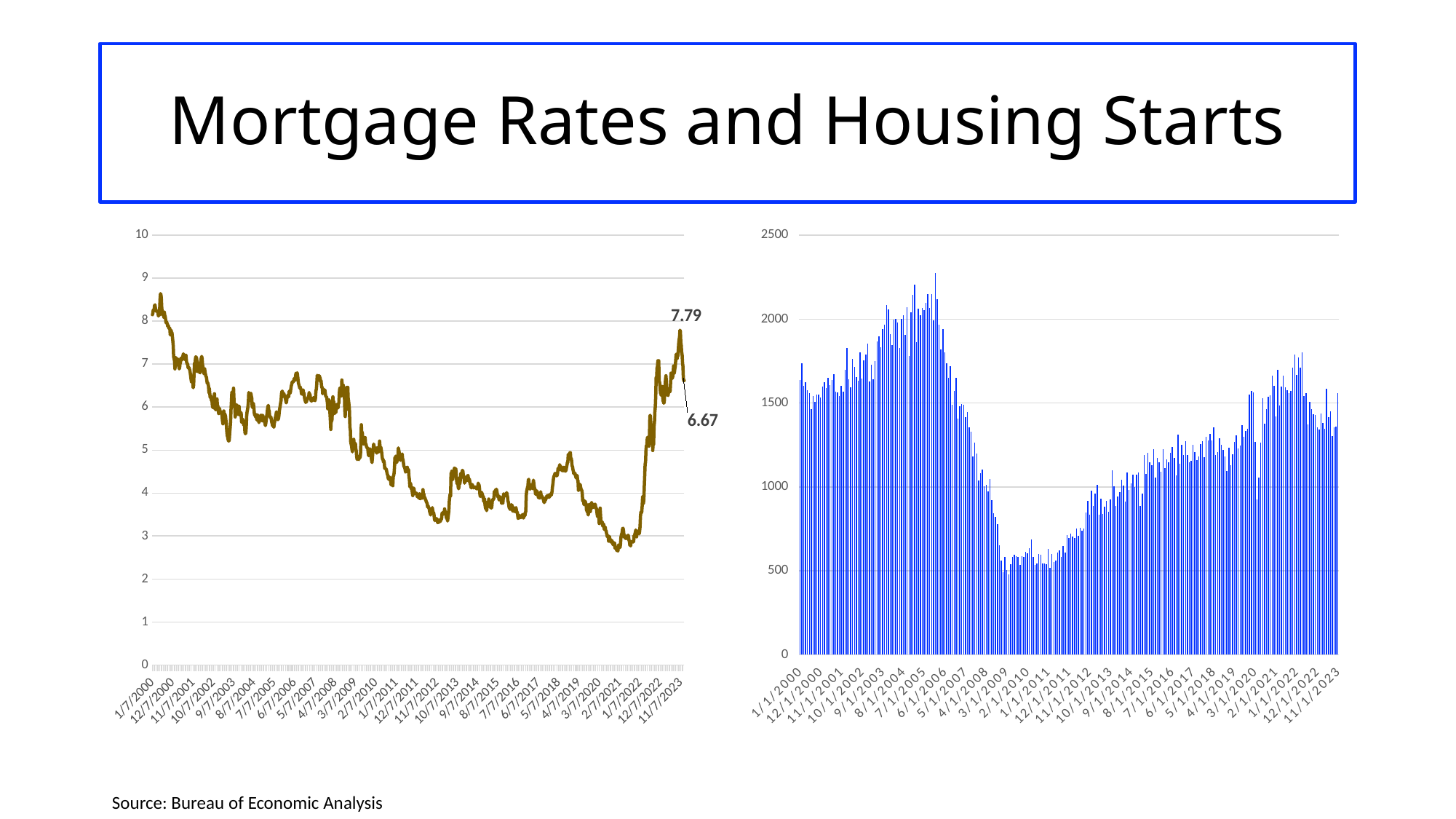
On the left chart, what is the difference between the two labelled values, 7.79 and 6.67? 1.12 On the left chart, which of the two labelled values is larger, 7.79 or 6.67? 7.79 What kind of chart is the chart on the right of the slide? bar chart On the right chart, are the bars around 2009 and 2010 greater or less than 1000? less On the left chart, what is the peak value labelled near the end of the series? 7.79 On the left chart, what is the final value labelled at the end of the series? 6.67 On the right chart, do the values rise or fall between 2006 and 2009? fall What source is cited at the bottom of the slide? Bureau of Economic Analysis What kind of chart is the chart on the left of the slide? line chart On the right chart, do the values generally rise or fall between 2010 and 2019? rise On the left chart, is the lowest point of the line, around early 2021, greater or less than 3? less On the left chart, is the value at the start of the series in 2000 greater or less than 8? greater